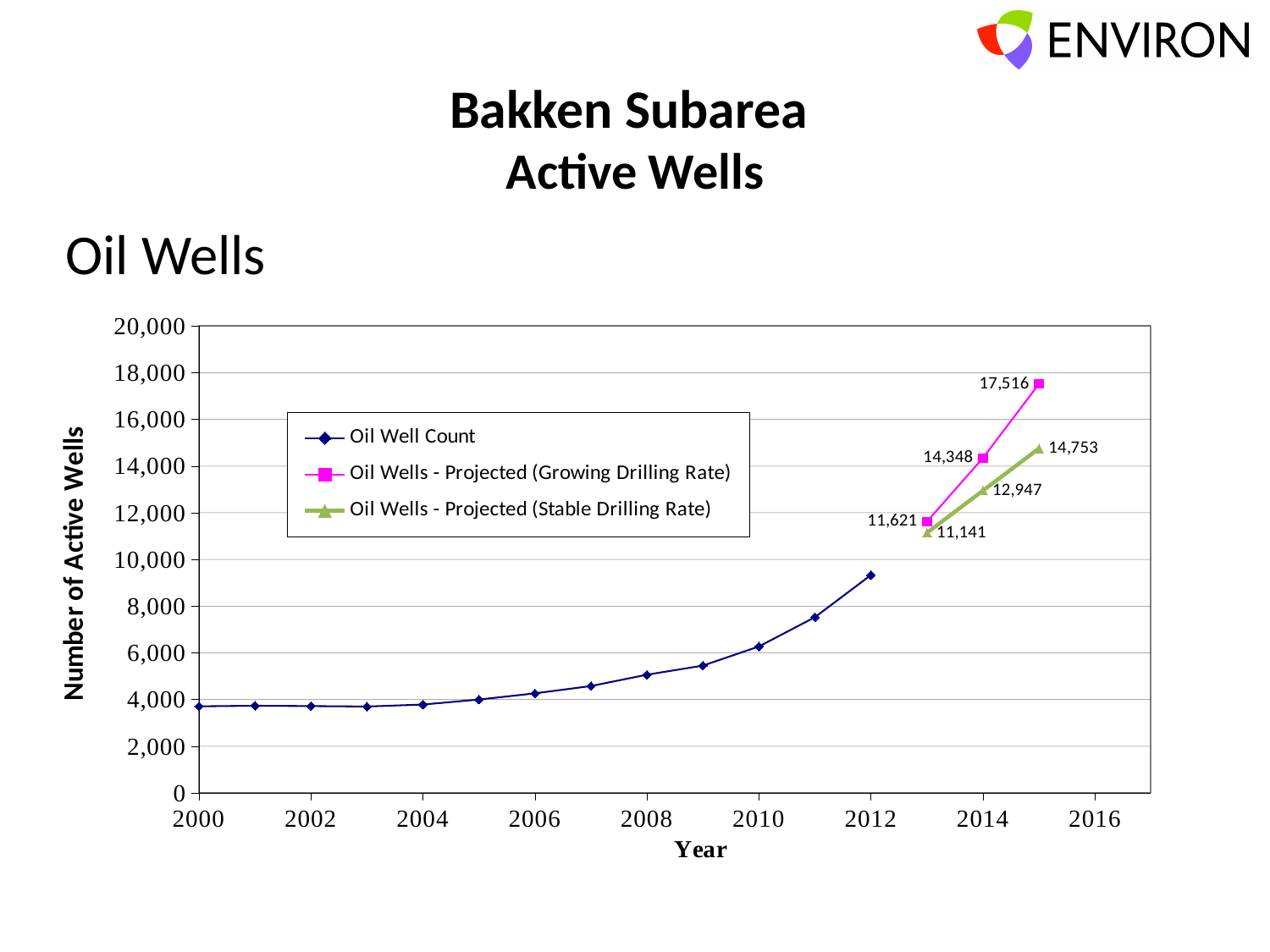
What is the projected number of oil wells in 2015 under the Stable Drilling Rate scenario? 14,753 Which projection is higher in 2013, Growing Drilling Rate or Stable Drilling Rate? Growing Drilling Rate Is the Oil Well Count value for 2012 greater or less than 10,000? less How many series does the legend list? 3 What is the difference between the Growing Drilling Rate and Stable Drilling Rate projections for 2014? 1,401 What is the projected number of oil wells in 2013 under the Growing Drilling Rate scenario? 11,621 What is the difference between the Growing Drilling Rate and Stable Drilling Rate projections for 2015? 2,763 What is the projected number of oil wells in 2014 under the Stable Drilling Rate scenario? 12,947 What kind of chart is shown on the slide? Line chart What is the projected number of oil wells in 2015 under the Growing Drilling Rate scenario? 17,516 Does the Oil Well Count series rise or fall from 2005 to 2012? Rise Is the Oil Well Count value for 2011 greater or less than 6,000? greater